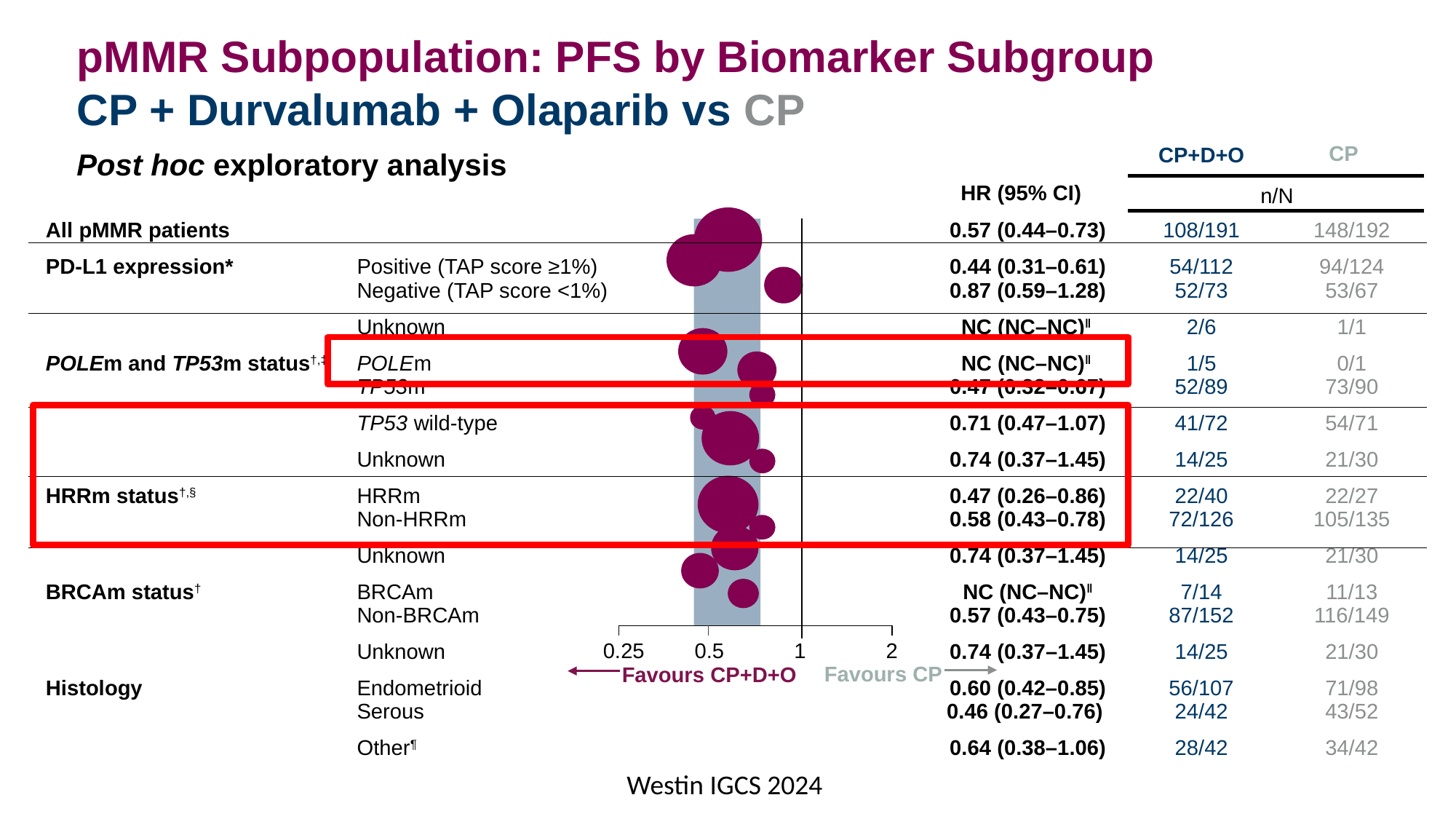
Which PD-L1 expression subgroup has the higher hazard ratio, Positive or Negative? Negative What is the HR (95% CI) for the PD-L1 Positive (TAP score ≥1%) subgroup? 0.44 (0.31–0.61) What is the HR (95% CI) for the Serous histology subgroup? 0.46 (0.27–0.76) Is the HR for the PD-L1 Negative (TAP score <1%) subgroup greater or less than 1? less What is the HR (95% CI) for All pMMR patients? 0.57 (0.44–0.73) What is the difference between the HR for Endometrioid and the HR for Serous histology? 0.14 What is the HR (95% CI) for the HRRm subgroup? 0.47 (0.26–0.86) What kind of chart is shown on the slide? Forest plot Among all subgroups with a numeric HR, which has the highest hazard ratio? PD-L1 Negative (TAP score <1%) What is the n/N for the CP+D+O arm in All pMMR patients? 108/191 Among the histology subgroups (Endometrioid, Serous, Other), which has the lowest hazard ratio? Serous What tick values are shown on the x axis of the forest plot? 0.25, 0.5, 1, 2